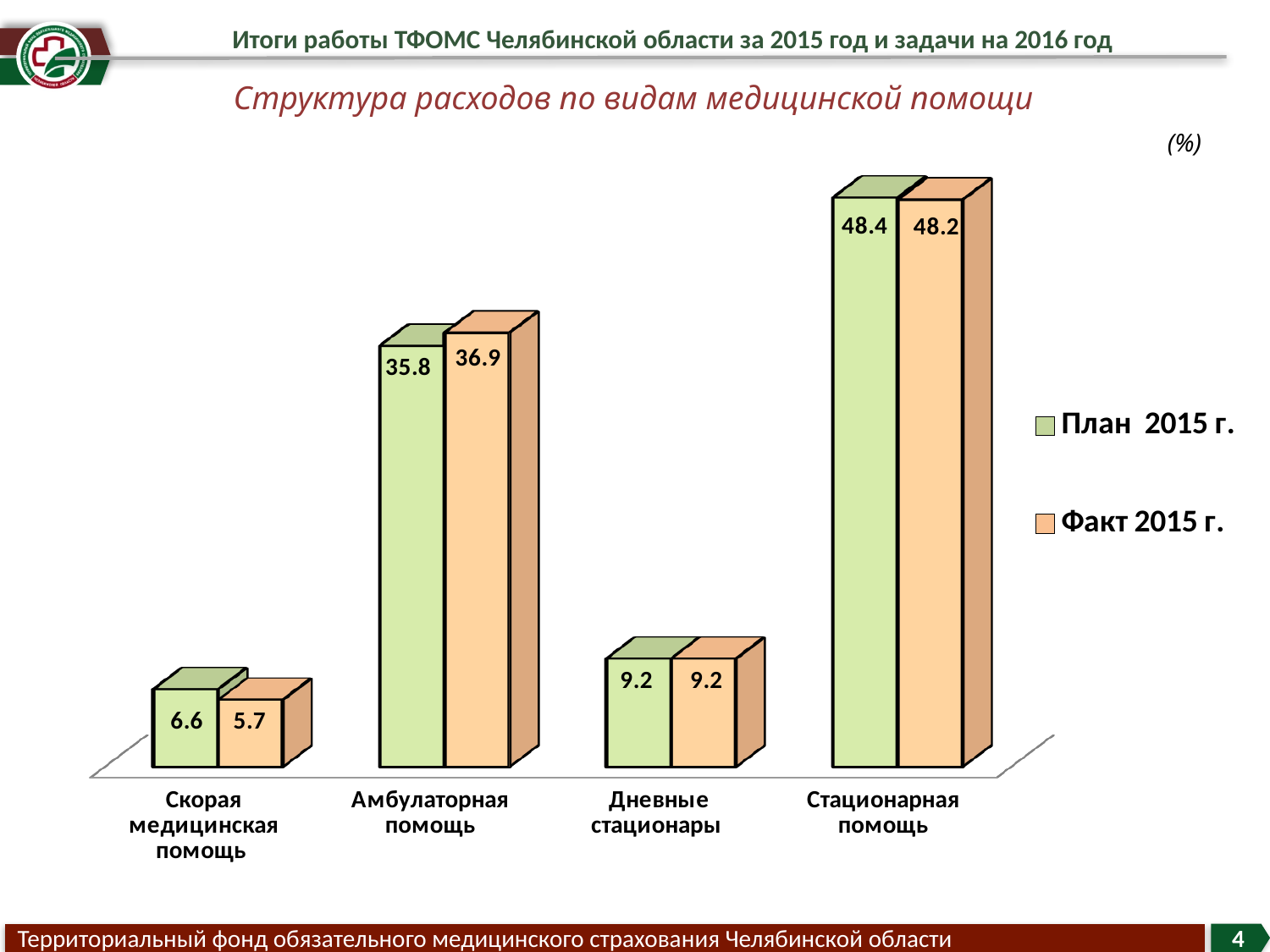
What is the difference between План 2015 г. and Факт 2015 г. for Амбулаторная помощь? 1.1 Which category has the highest value for План 2015 г.? Стационарная помощь How many series does the legend list? 2 What kind of chart is shown on the slide? Bar chart What is the value for План 2015 г. for Скорая медицинская помощь? 6.6 How many categories are shown on the x axis? 4 What is the value for План 2015 г. for Дневные стационары? 9.2 What is the difference between План 2015 г. and Факт 2015 г. for Скорая медицинская помощь? 0.9 What is the value for Факт 2015 г. for Стационарная помощь? 48.2 For Амбулаторная помощь, which is larger: План 2015 г. or Факт 2015 г.? Факт 2015 г. Which category has the lowest value for Факт 2015 г.? Скорая медицинская помощь What is the value for Факт 2015 г. for Амбулаторная помощь? 36.9